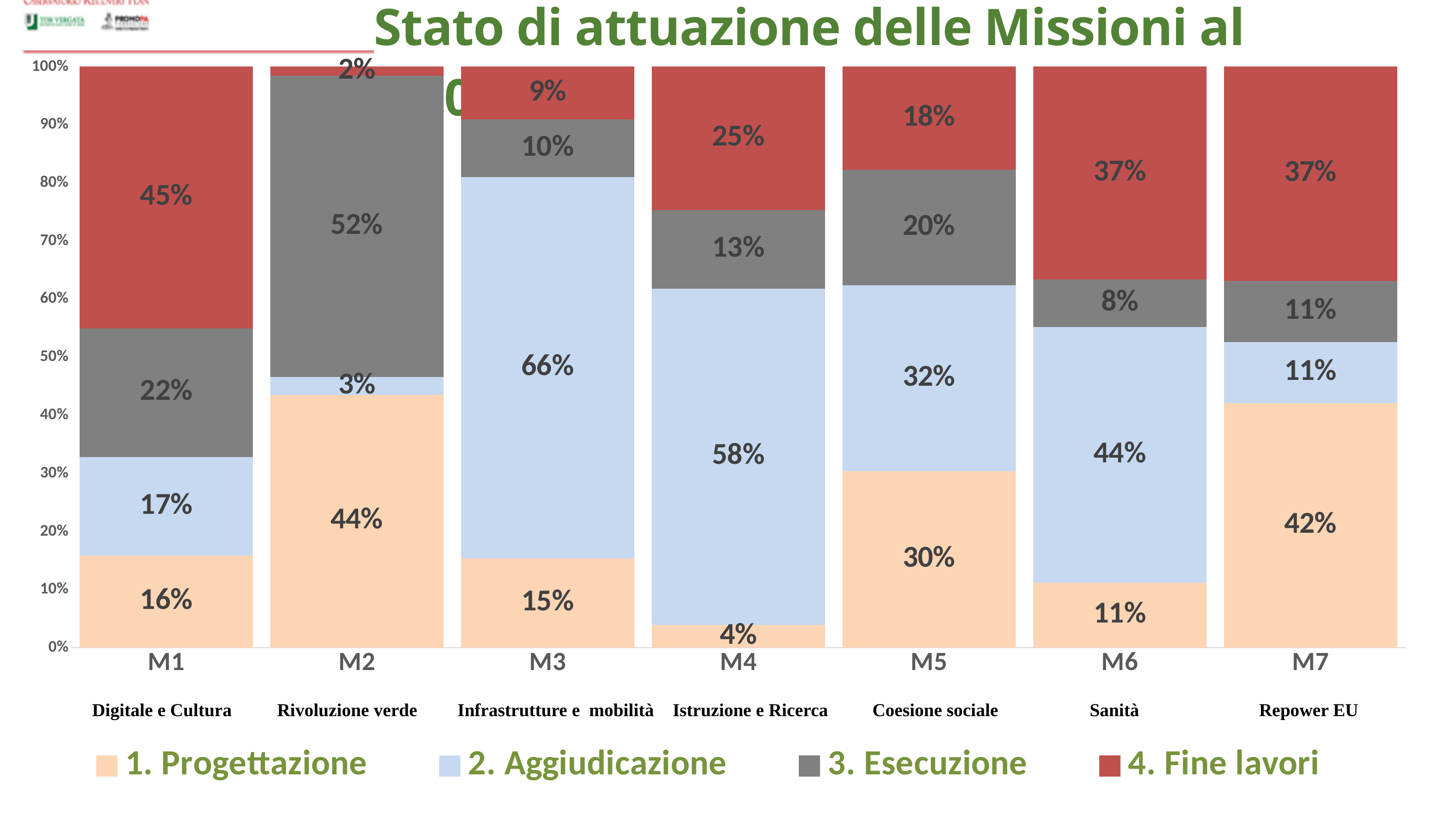
What is the value of 4. Fine lavori for M1? 45% How many missions (categories) are shown on the x axis? 7 What kind of chart is shown on the slide? Stacked bar chart Which colour represents 4. Fine lavori in the legend? Red What is the value of 3. Esecuzione for M6? 8% Which mission has the lowest value for 1. Progettazione? M4 How many series does the legend list? 4 What is the value of 2. Aggiudicazione for M3? 66% Which mission has the highest value for 3. Esecuzione? M2 What is the value of 1. Progettazione for M5? 30% Which is larger: the 2. Aggiudicazione value for M4 or for M5? M4 What is the difference between the 4. Fine lavori values for M1 and M4? 20%